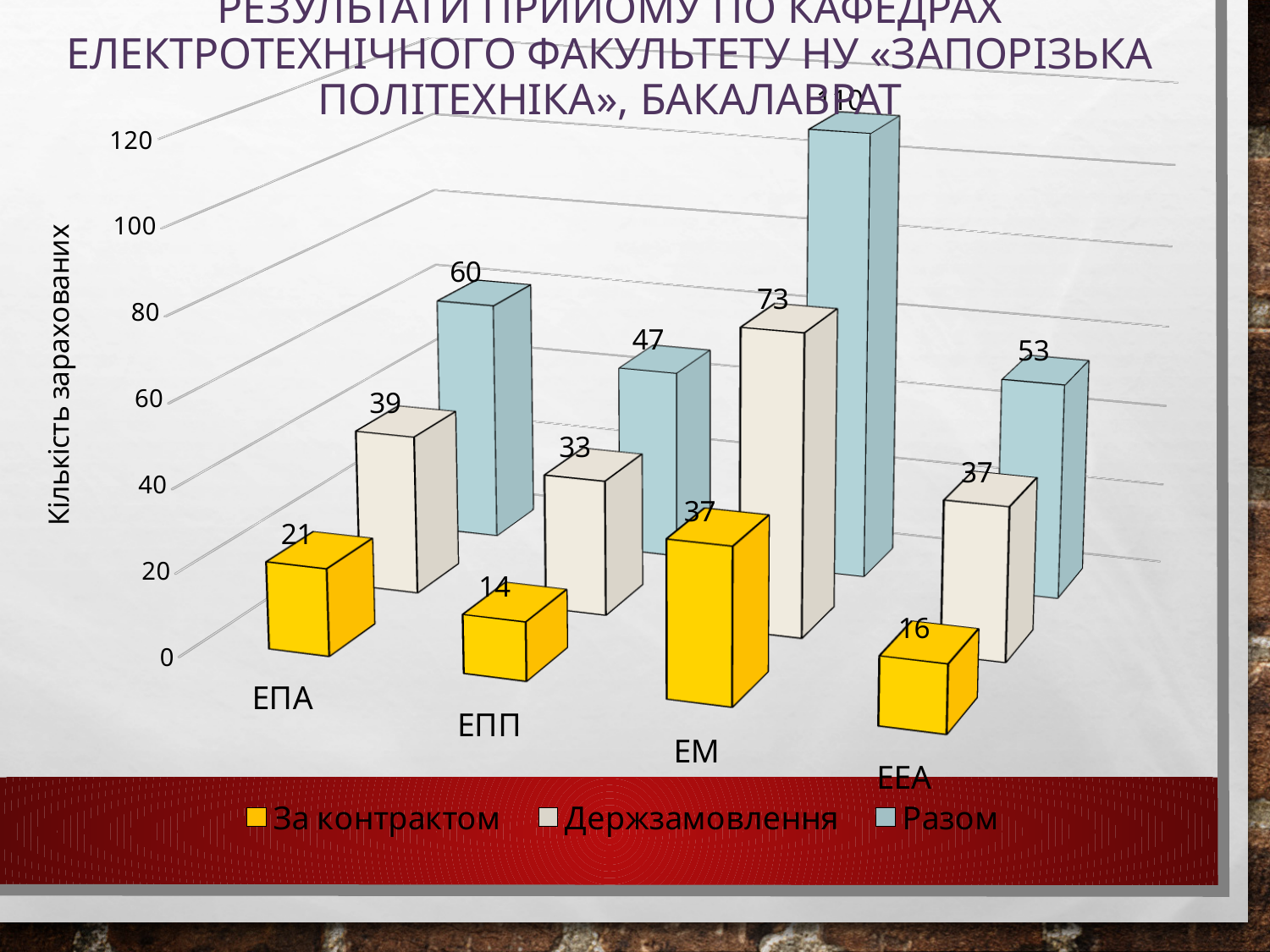
Which is larger: Держзамовлення for ЕПА or Держзамовлення for ЕЕА? ЕПА Which department has the highest Держзамовлення value? ЕМ What is the value of Держзамовлення for ЕМ? 73 How many series does the legend list? 3 What is the value of За контрактом for ЕПА? 21 Which department has the lowest За контрактом value? ЕПП What kind of chart is shown on the slide? bar chart What is the value of Разом for ЕЕА? 53 What is the difference between the Разом values for ЕПА and ЕПП? 13 How many departments (categories) are shown on the x axis? 4 What is the value of За контрактом for ЕПП? 14 What is the label of the vertical axis? Кількість зарахованих